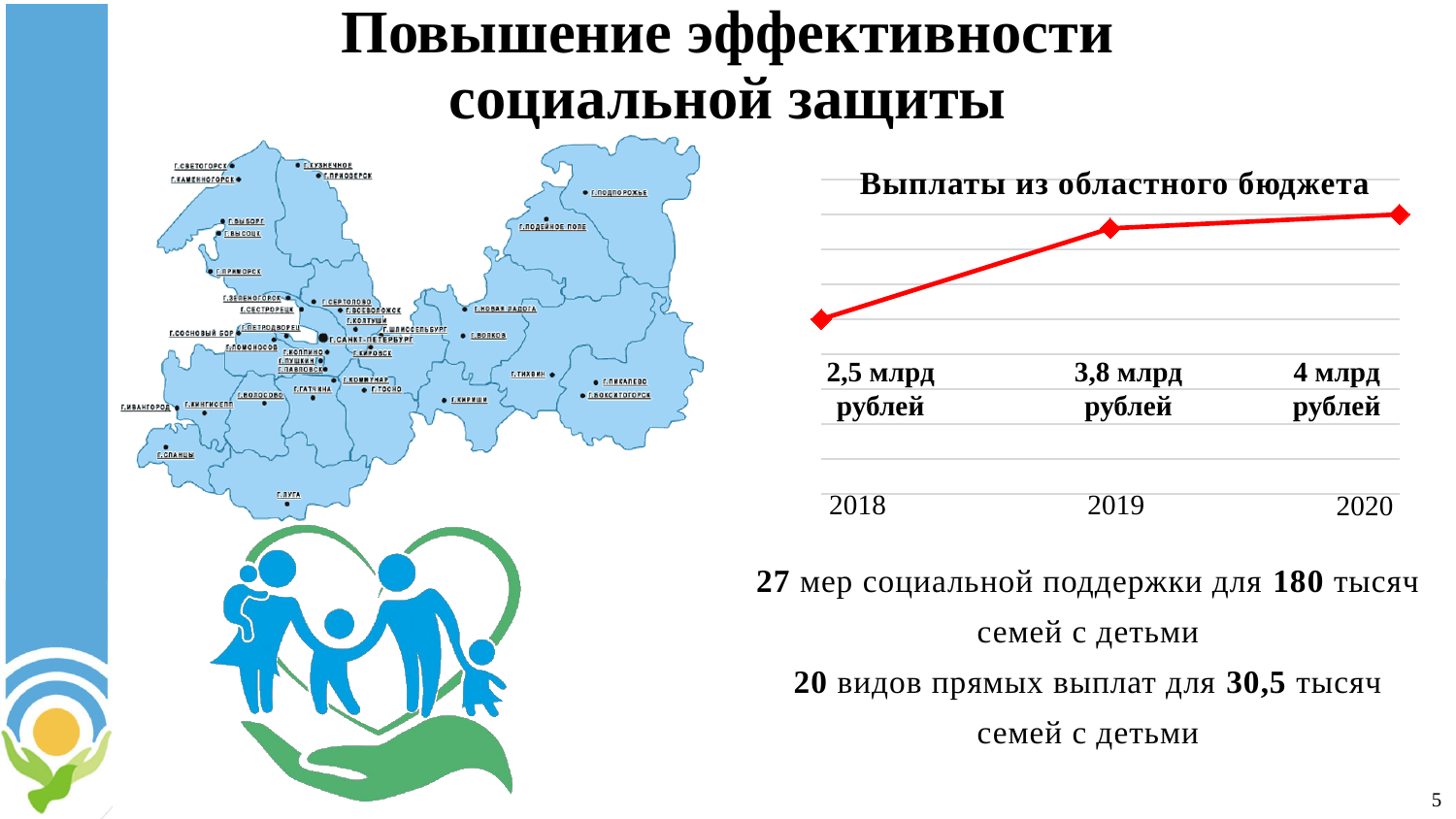
What type of chart is shown on the slide? line chart What is the difference between the payments in 2020 and in 2018? 1,5 млрд рублей How many years (data points) are plotted on the chart? 3 Which year has the highest value of payments from the regional budget? 2020 What is the value of payments from the regional budget in 2018? 2,5 млрд рублей What is the value of payments from the regional budget in 2020? 4 млрд рублей Which is larger: the payments in 2019 or in 2018? 2019 What is the title of the chart on the slide? Выплаты из областного бюджета Which year has the lowest value of payments from the regional budget? 2018 Do the payments from the regional budget rise or fall from 2018 to 2020? rise What is the value of payments from the regional budget in 2019? 3,8 млрд рублей By how much did payments from the regional budget increase from 2018 to 2019? 1,3 млрд рублей